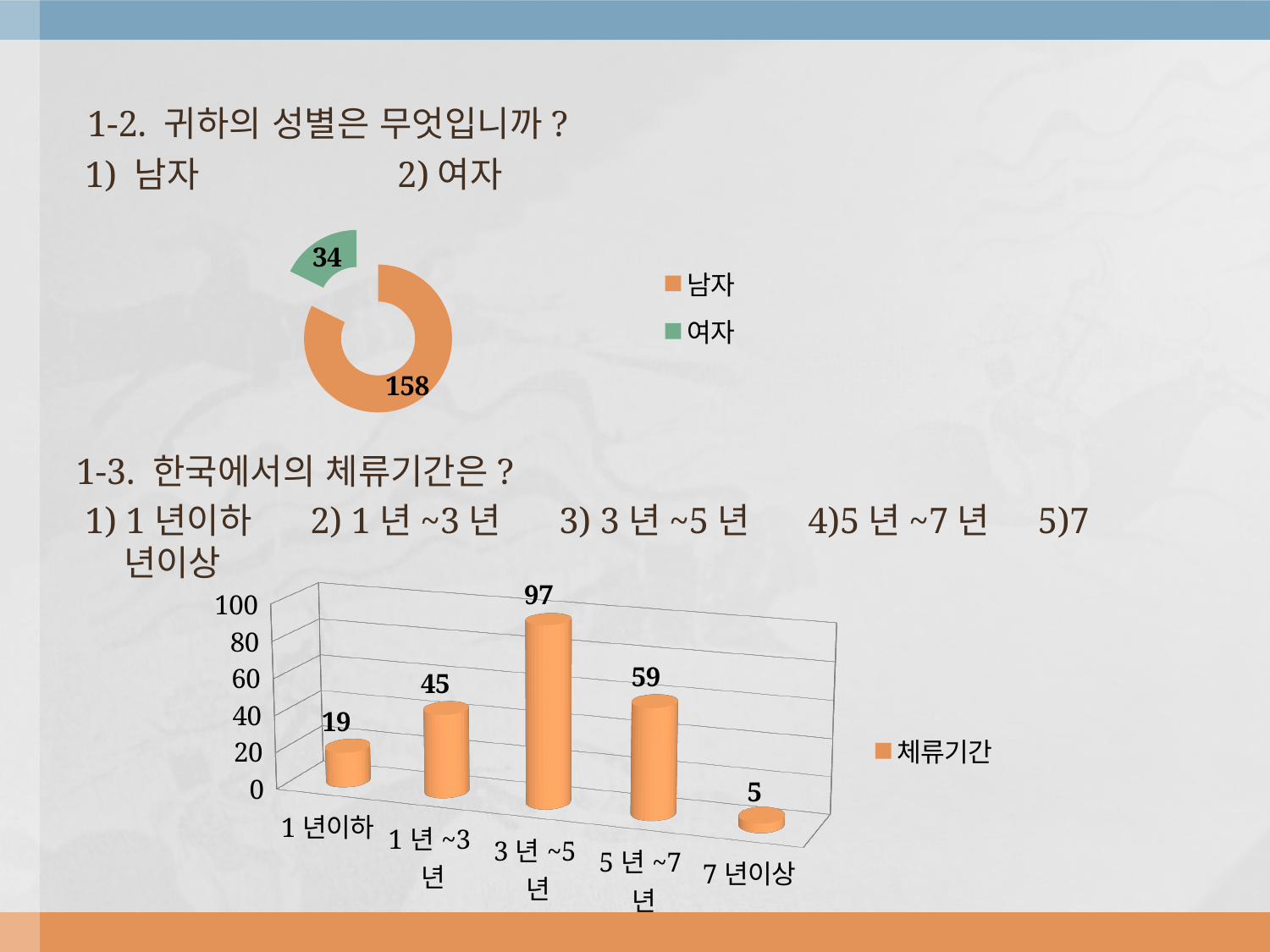
How many categories are shown in the bar chart at the bottom of the slide? 5 In the bar chart at the bottom of the slide, what is the value for 3 년 ~5 년? 97 In the bar chart at the bottom of the slide, what is the difference between the values for 5 년 ~7 년 and 1 년 ~3 년? 14 In the doughnut chart at the top of the slide, which category is larger, 남자 or 여자? 남자 In the bar chart at the bottom of the slide, which category has the highest value? 3 년 ~5 년 In the doughnut chart at the top of the slide, what is the value for 남자? 158 How many entries does the legend of the doughnut chart at the top of the slide list? 2 In the bar chart at the bottom of the slide, what is the value for 1 년이하? 19 In the doughnut chart at the top of the slide, what is the difference between the values for 남자 and 여자? 124 In the doughnut chart at the top of the slide, what is the value for 여자? 34 What kind of chart is the chart at the bottom of the slide? bar chart In the bar chart at the bottom of the slide, which category has the lowest value? 7 년이상